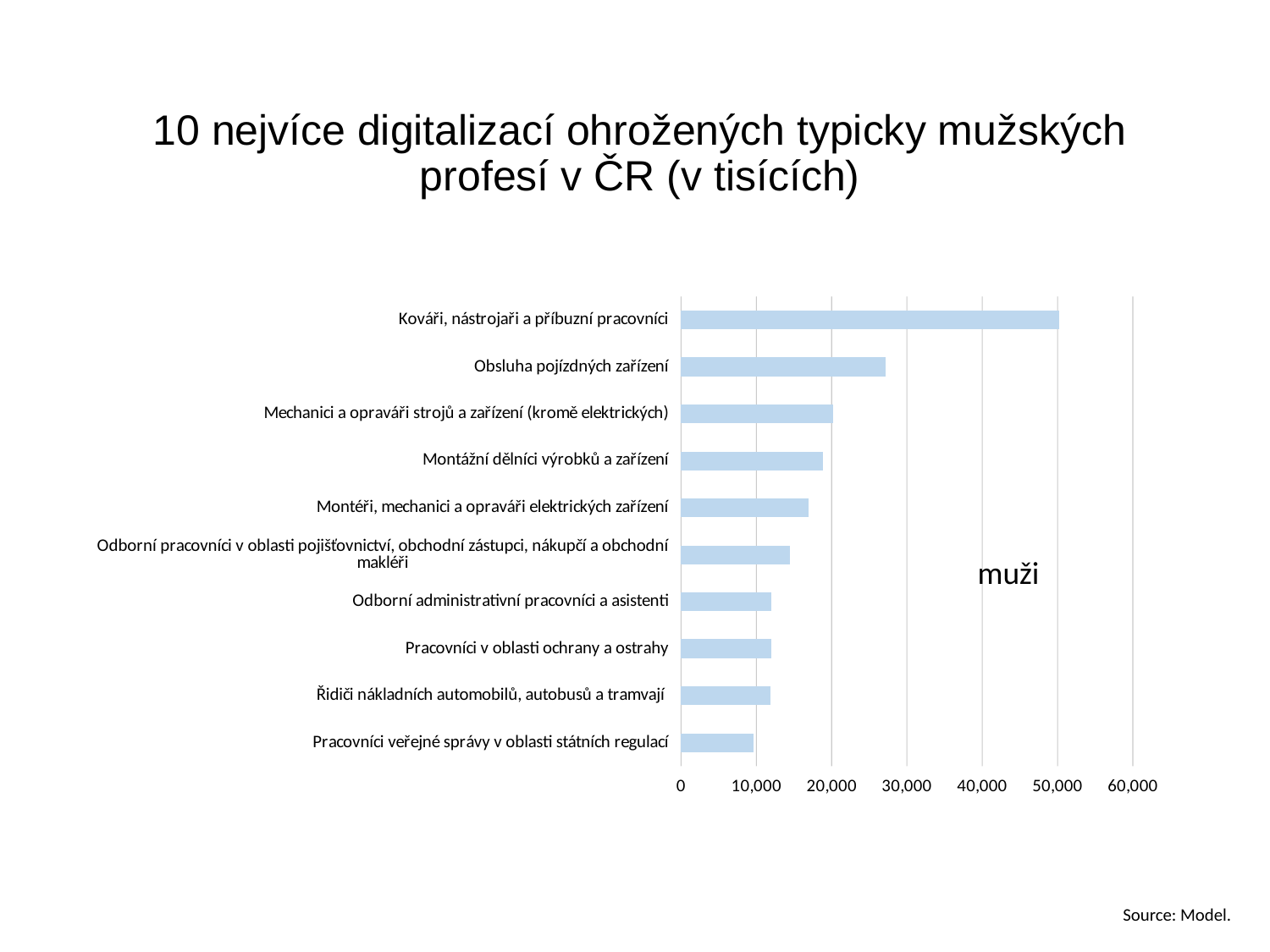
Which profession has the highest value in the chart? Kováři, nástrojaři a příbuzní pracovníci Is the value for Obsluha pojízdných zařízení greater or less than 30,000? less What is the legend entry shown in the chart? muži What kind of chart is shown on the slide? bar chart Is the value for Kováři, nástrojaři a příbuzní pracovníci greater or less than 40,000? greater Is the value for Montéři, mechanici a opraváři elektrických zařízení greater or less than 20,000? less Which profession has the lowest value in the chart? Pracovníci veřejné správy v oblasti státních regulací Which has the larger value: Obsluha pojízdných zařízení or Montážní dělníci výrobků a zařízení? Obsluha pojízdných zařízení How many professions (categories) are plotted in the chart? 10